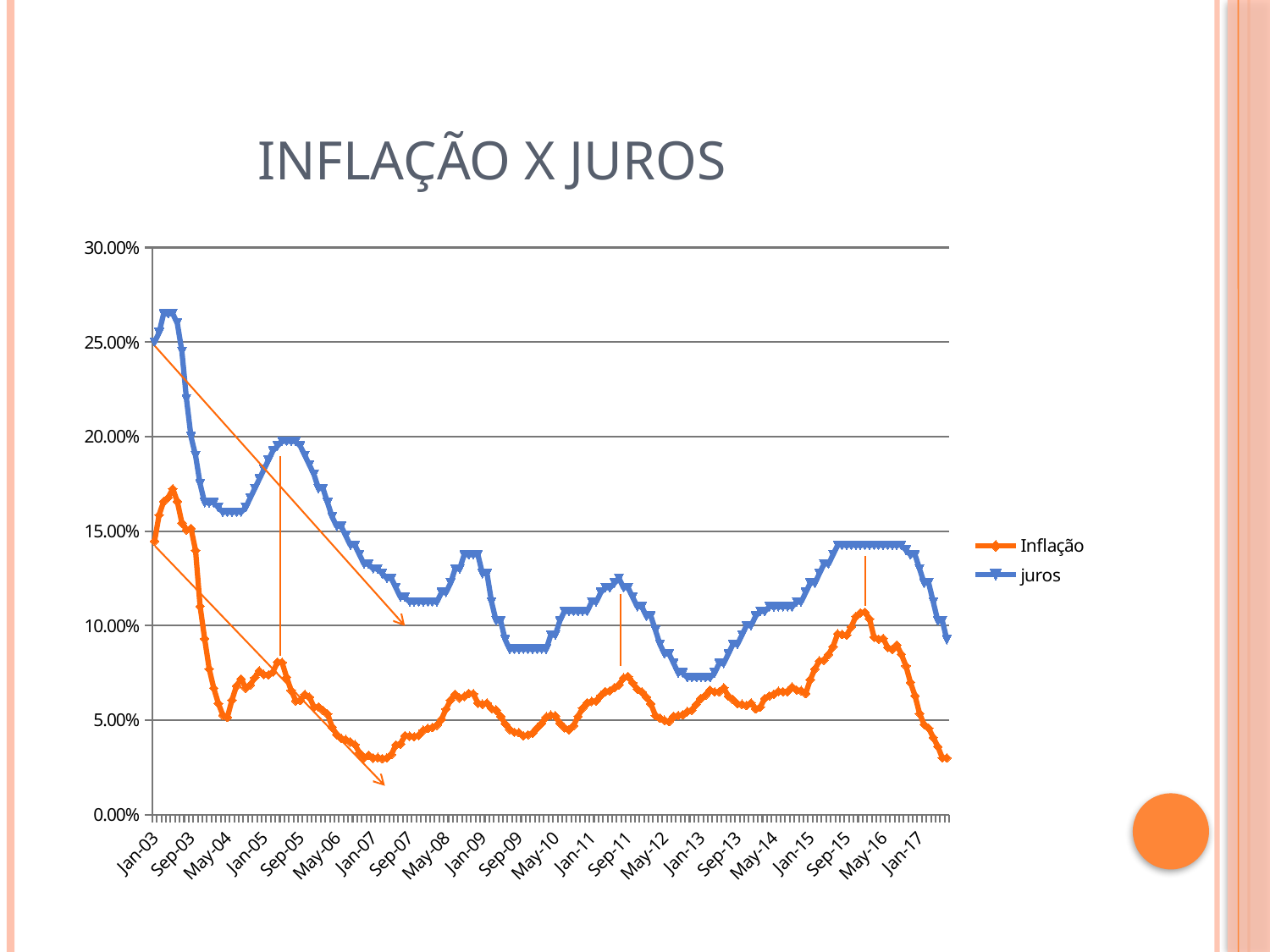
Is the value of juros at Jan-13 greater or less than 10.00%? less What kind of chart is shown on the slide? line chart At Jan-03, which series has the larger value, Inflação or juros? juros Does the juros series overall rise or fall from Jan-03 to Jan-17? fall What is the title of the chart? INFLAÇÃO X JUROS Is the value of juros at Sep-09 greater or less than 10.00%? less In which year does the juros series reach its highest value? 2003 Is the value of Inflação at Jan-13 greater or less than 5.00%? greater Which colour is used for the juros series? blue How many series does the legend list? 2